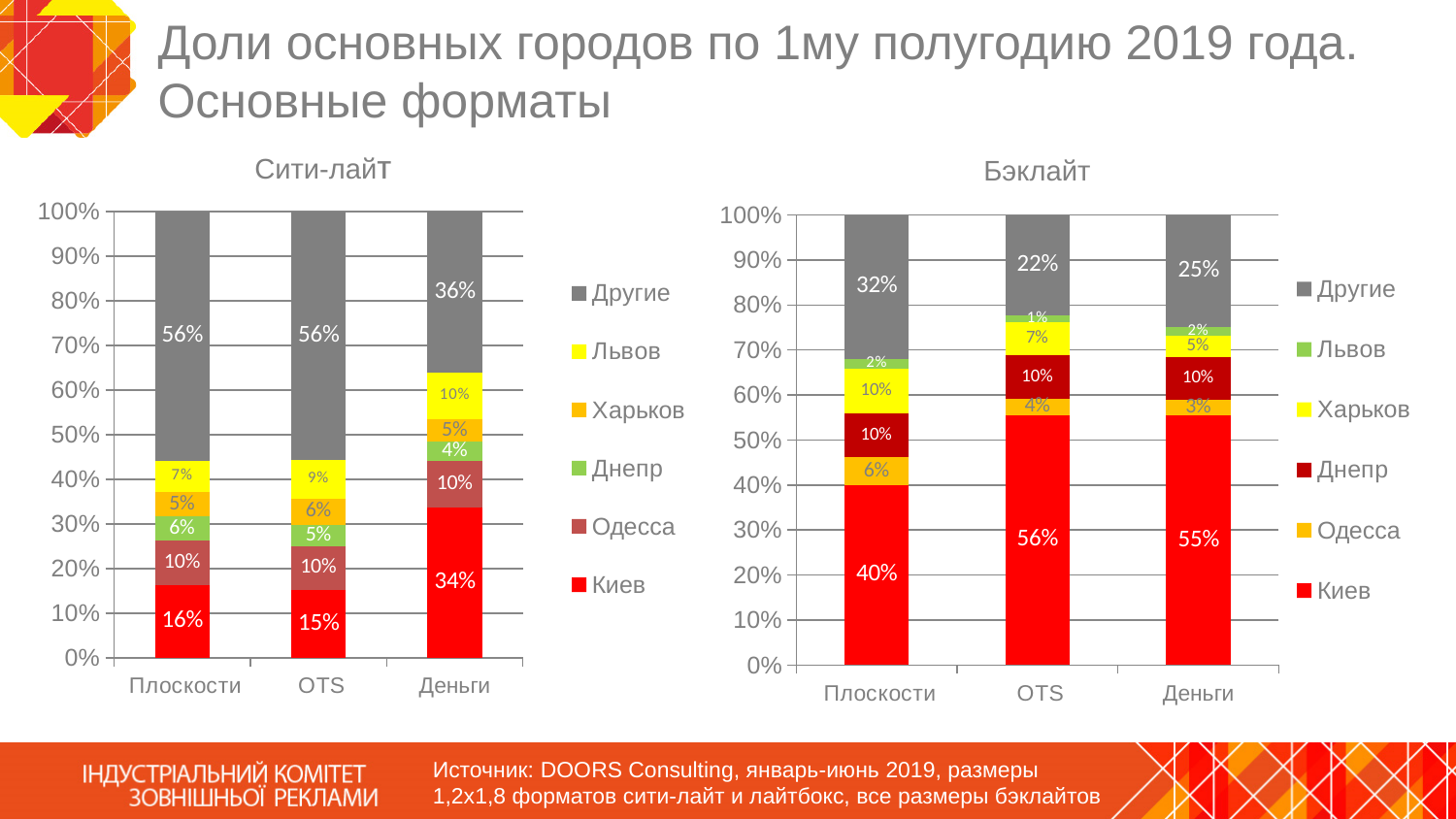
In the Бэклайт chart, what is the value for Днепр in the Деньги bar? 10% In the Бэклайт chart, which is larger: Киев for Плоскости or Киев for Деньги? Деньги In the Сити-лайт chart, what is the value for Киев in the Деньги bar? 34% In the Бэклайт chart, what is the value for Другие in the Плоскости bar? 32% What kind of chart is the Бэклайт chart? Stacked bar chart How many series does the legend of the Бэклайт chart list? 6 How many categories are shown on the x axis of the Сити-лайт chart? 3 In the Сити-лайт chart, what is the difference between the Другие values for Плоскости and Деньги? 20% In the Сити-лайт chart, what is the value for Другие in the Плоскости bar? 56% In the Бэклайт chart, what is the value for Киев in the OTS bar? 56% In the Бэклайт chart, which category has the lowest value for Другие? OTS In the Сити-лайт chart, which category has the highest value for Киев? Деньги